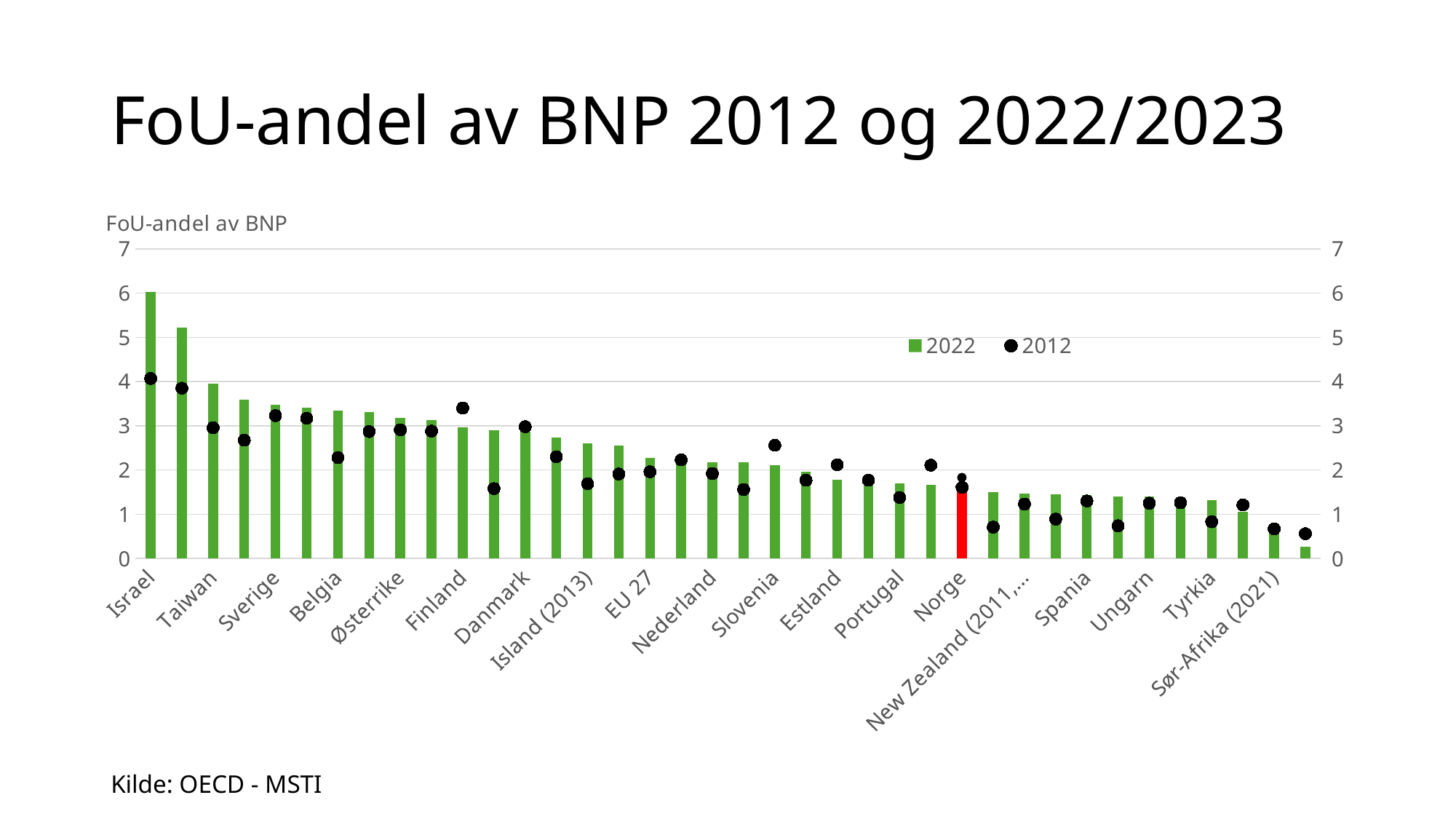
Is the 2022 value for Norge greater or less than 2? less What are the two entries in the chart legend? 2022 and 2012 Is the 2022 value for Sør-Afrika (2021) greater or less than 1? less For Finland, which is larger, the 2012 value or the 2022 value? 2012 Which country's 2022 bar is coloured red instead of green? Norge Which is larger, the 2022 value for Israel or the 2022 value for Taiwan? Israel Do the 2022 bar values rise or fall from left to right along the x axis? fall What kind of chart is shown on the slide? bar chart Is the 2022 value for Israel greater or less than 5? greater Which country has the highest 2022 bar? Israel How many series does the legend list? 2